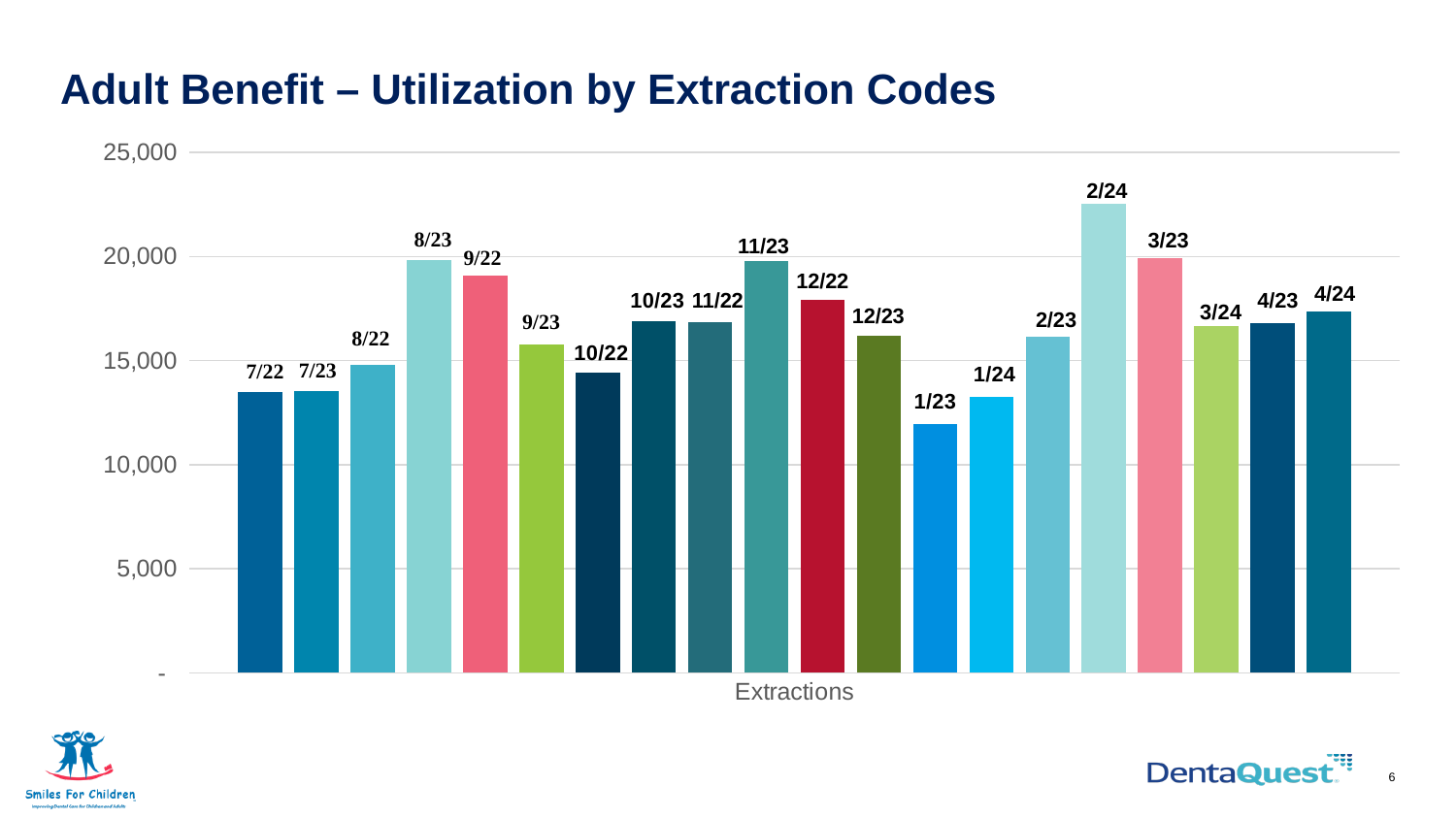
Which is larger, the value for 9/22 or the value for 9/23? 9/22 How many bars are plotted in the chart? 20 Which month has the highest number of extractions? 2/24 Which month has the lowest number of extractions? 1/23 Is the value for 2/24 greater or less than 20,000? greater What is the title of the chart? Adult Benefit – Utilization by Extraction Codes What kind of chart is shown on the slide? bar chart Is the value for 10/22 greater or less than 15,000? less What label appears under the x axis of the chart? Extractions Which is larger, the value for 1/23 or the value for 1/24? 1/24 Is the value for 1/23 greater or less than 15,000? less